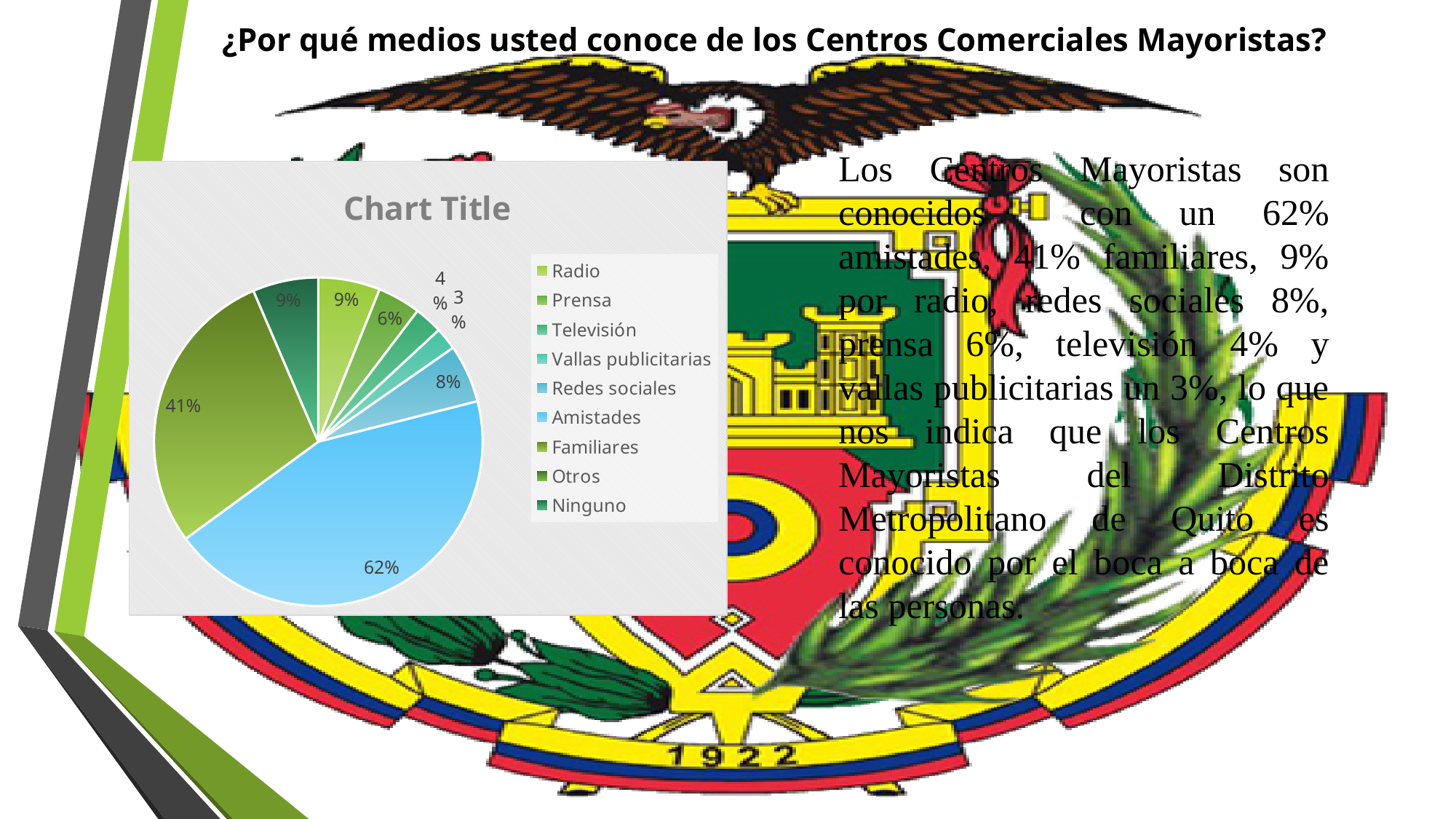
What type of chart is shown on the slide? Pie chart What is the difference in percentage points between Amistades and Familiares? 21 Which category has the largest slice of the pie? Amistades What percentage is shown for Prensa? 6% What percentage is shown for Televisión? 4% What percentage is shown for Redes sociales? 8% What percentage is shown for Vallas publicitarias? 3% What percentage is shown for Amistades? 62% How many categories does the chart's legend list? 9 What is the title shown on the chart? Chart Title What percentage is shown for Familiares? 41% Which is larger, the slice for Familiares or the slice for Redes sociales? Familiares